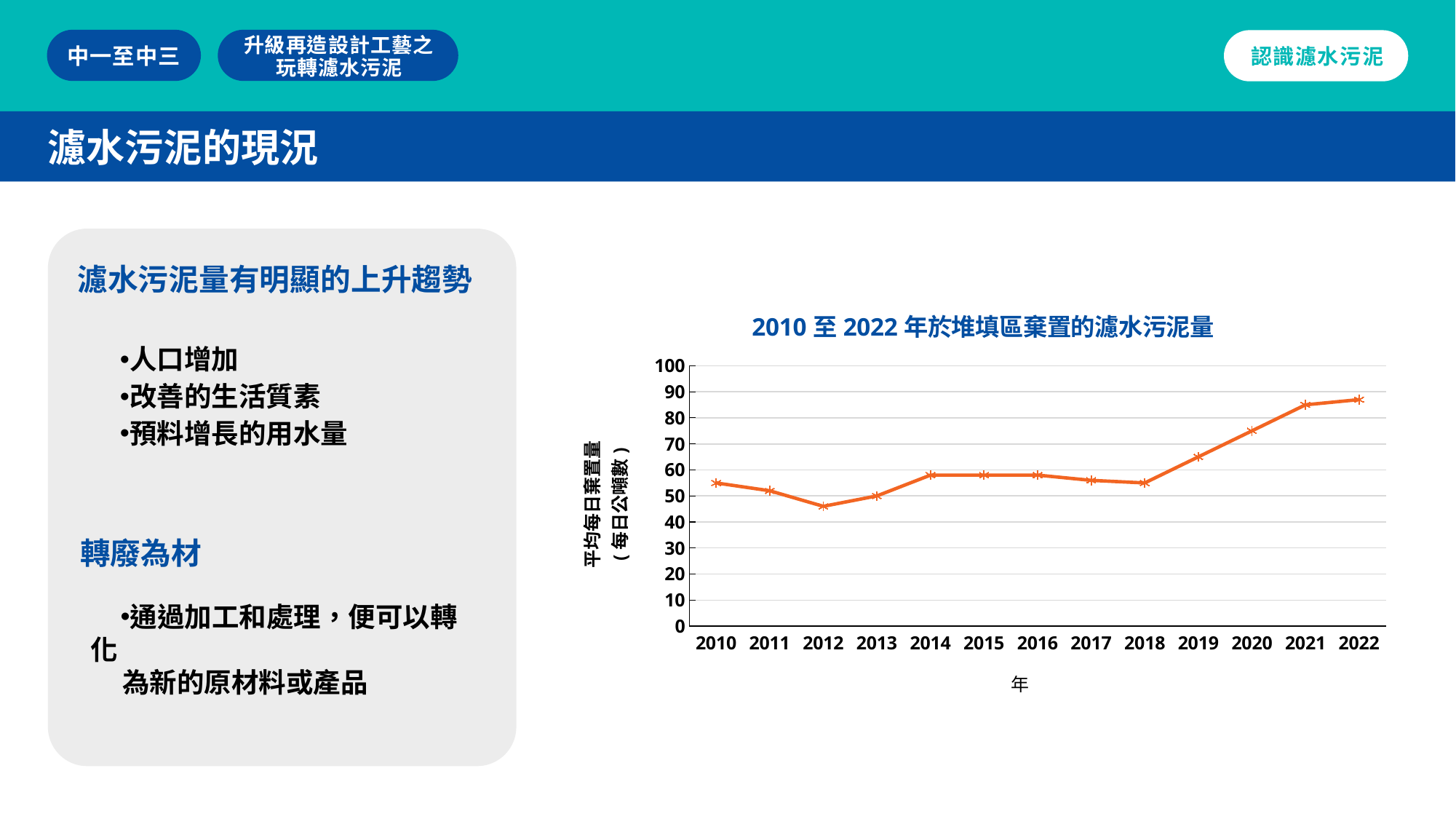
Is the value for 2021 greater or less than 80? greater What kind of chart is shown on the slide? line chart Is the value for 2019 greater or less than 60? greater What is the title of the chart? 2010 至 2022 年於堆填區棄置的濾水污泥量 Which year has the lowest value on the chart? 2012 Which year has the larger value, 2012 or 2020? 2020 What is the label on the x axis of the chart? 年 How many years (data points) are plotted on the chart? 13 Is the value for 2012 greater or less than 50? less Do the values rise or fall from 2018 to 2022? rise